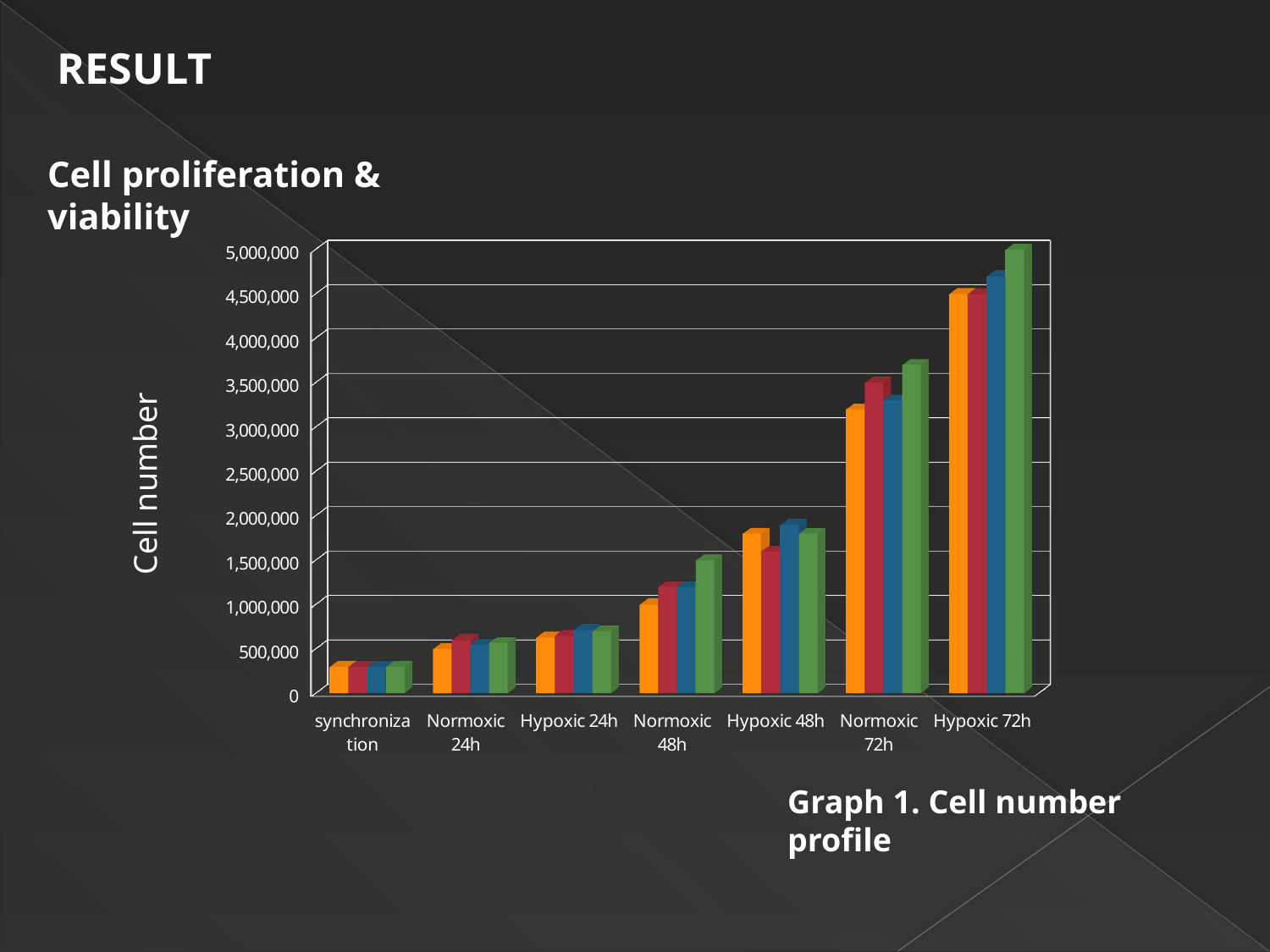
Are the bars for Normoxic 72h greater or less than 3,000,000? greater Which category has the tallest bars in the chart? Hypoxic 72h How many categories are shown along the x axis of the chart? 7 What kind of chart is shown on the slide? bar chart Are the bars for Hypoxic 72h greater or less than 4,000,000? greater Which category has the shortest bars in the chart? synchronization What is the title of the vertical axis of the chart? Cell number Which category has higher bars, Normoxic 72h or Hypoxic 48h? Normoxic 72h Are the bars for Normoxic 24h greater or less than 1,000,000? less Do the cell numbers generally rise or fall from left to right across the categories? rise How many bars are plotted for each category in the chart? 4